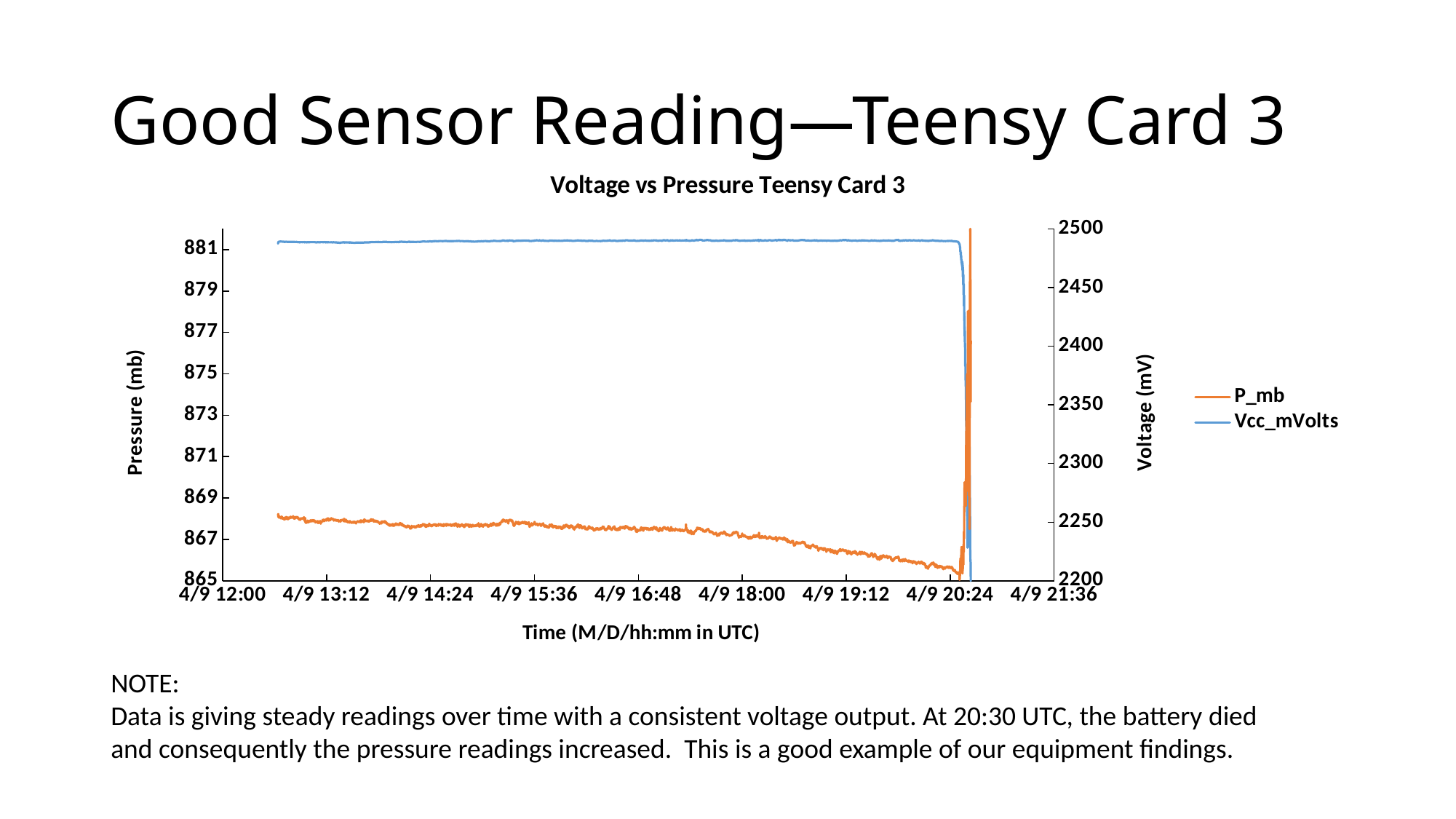
Is the P_mb value at 4/9 19:12 greater or less than 865? greater What is the title of the chart? Voltage vs Pressure Teensy Card 3 Is the P_mb value at 4/9 16:48 greater or less than 869? less Is the P_mb value at 4/9 13:12 greater or less than 867? greater Which series is drawn in orange in the chart? P_mb How many series does the chart legend list? 2 Between 4/9 13:12 and 4/9 20:00, does the Vcc_mVolts series rise, fall, or stay roughly flat? stay roughly flat Between 4/9 18:00 and 4/9 20:24, does the P_mb series rise or fall? fall What kind of chart is shown on the slide? line chart